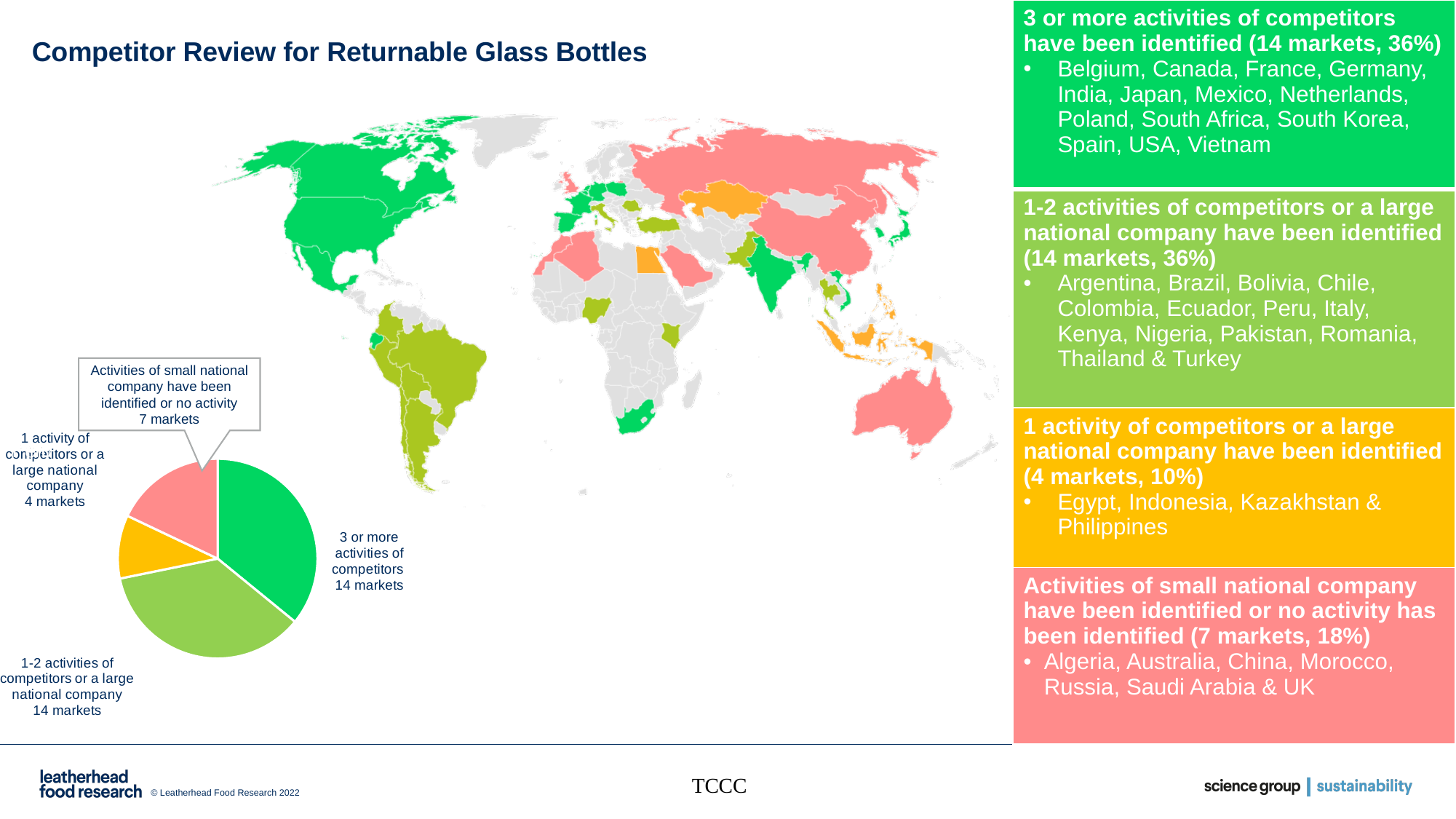
How many markets are in the '3 or more activities of competitors' slice of the pie chart? 14 markets What share of the pie chart does the 'Activities of small national company / no activity' slice represent, according to the slide? 18% How many markets are in the '1-2 activities of competitors or a large national company' slice of the pie chart? 14 markets Which slice of the pie chart represents the fewest markets? 1 activity of competitors or a large national company What is the difference in number of markets between the 'Activities of small national company / no activity' slice and the '1 activity of competitors or a large national company' slice? 3 markets Which slice is larger in the pie chart: 'Activities of small national company / no activity' or '1 activity of competitors or a large national company'? Activities of small national company / no activity What is the difference in number of markets between the '3 or more activities of competitors' slice and the 'Activities of small national company / no activity' slice? 7 markets How many markets are in the '1 activity of competitors or a large national company' slice of the pie chart? 4 markets What is the total number of markets represented across all slices of the pie chart? 39 markets How many slices does the pie chart have? 4 How many markets are in the 'Activities of small national company have been identified or no activity' slice of the pie chart? 7 markets What kind of chart is shown on the slide? pie chart